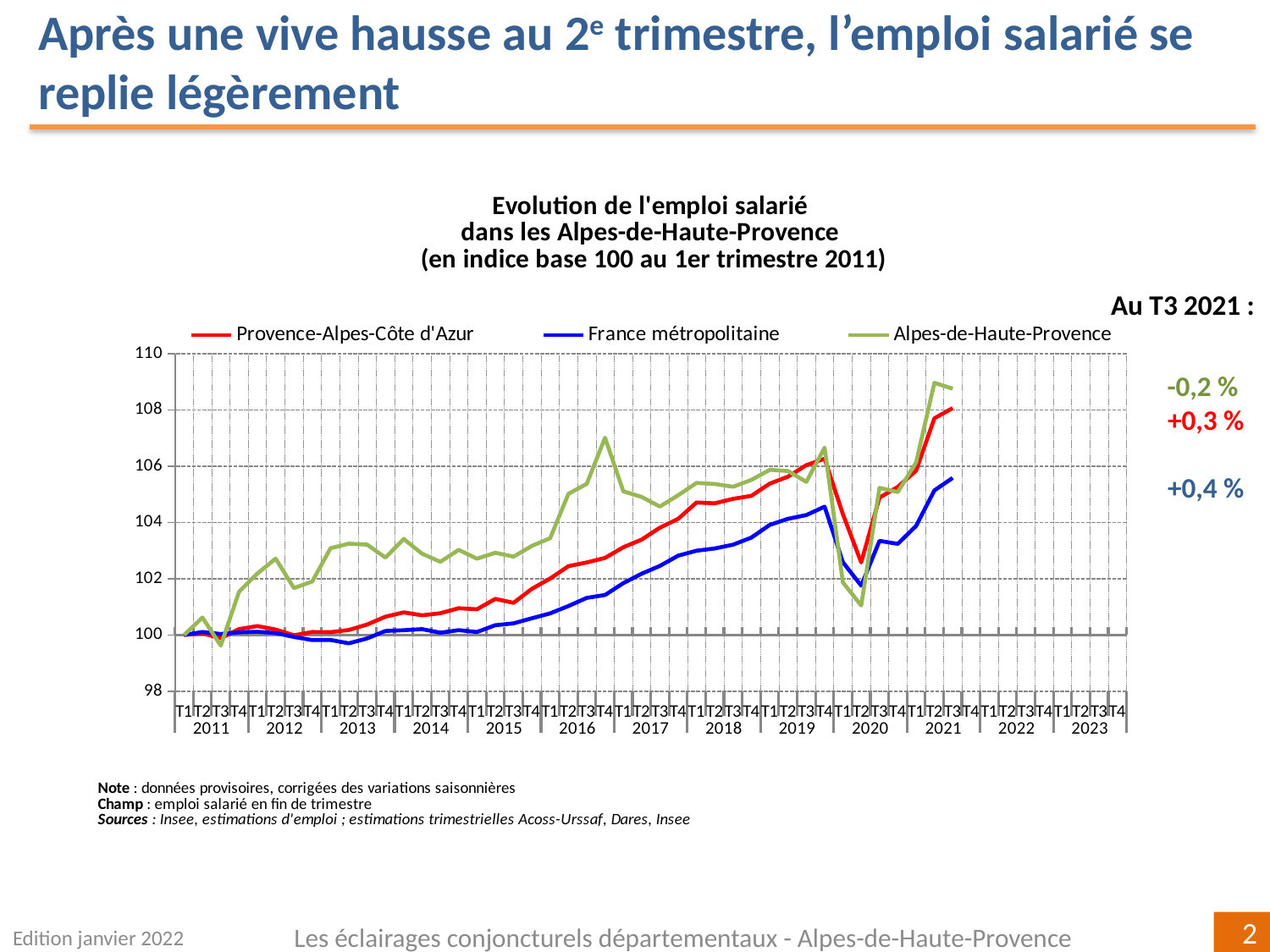
Which three series are listed in the chart legend? Provence-Alpes-Côte d'Azur, France métropolitaine, Alpes-de-Haute-Provence Is the value for Alpes-de-Haute-Provence at T2 2020 greater or less than 102? less At T3 2021, which series is higher: Provence-Alpes-Côte d'Azur or France métropolitaine? Provence-Alpes-Côte d'Azur How many series does the legend of the chart list? 3 Does the France métropolitaine series rise or fall between 2013 and 2019? rise What quarterly change is shown for Alpes-de-Haute-Provence at T3 2021 in the annotation to the right of the chart? -0,2 % What kind of chart is shown on the slide? line chart Which series reaches the highest index value at T3 2021? Alpes-de-Haute-Provence Is the value for Provence-Alpes-Côte d'Azur at T3 2016 greater or less than 104? less What quarterly change is shown for France métropolitaine at T3 2021 in the annotation to the right of the chart? +0,4 % Is the value for France métropolitaine at T3 2021 greater or less than 106? less